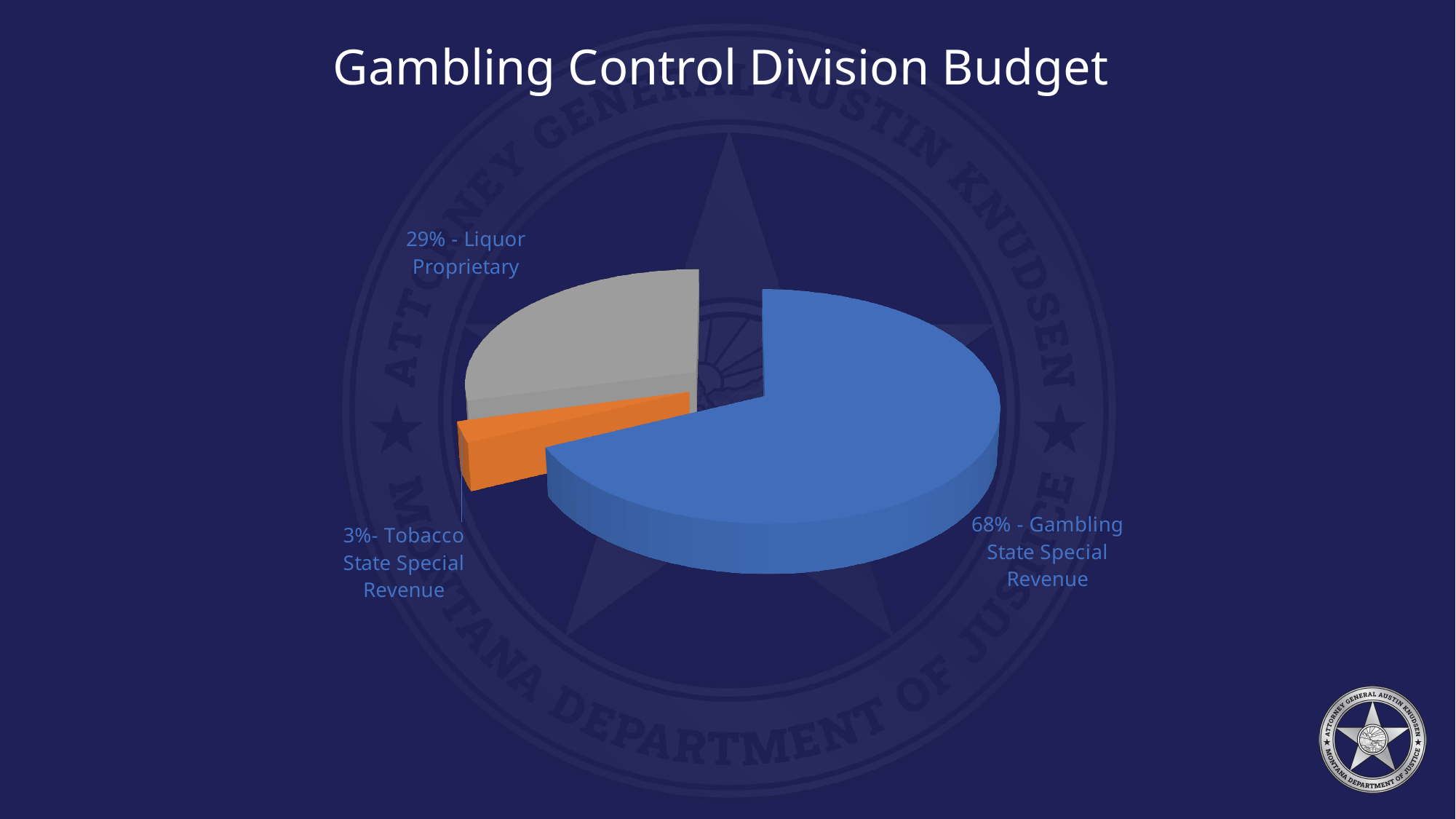
What is the title of the chart? Gambling Control Division Budget What share of the budget comes from Liquor Proprietary? 29% Which funding source makes up the smallest share of the budget? Tobacco State Special Revenue What is the difference in percentage points between the Liquor Proprietary share and the Tobacco State Special Revenue share? 26 Which funding source makes up the largest share of the budget? Gambling State Special Revenue What kind of chart is shown on the slide? Pie chart What share of the budget comes from Gambling State Special Revenue? 68% Which is larger, the Liquor Proprietary share or the Tobacco State Special Revenue share? Liquor Proprietary How many slices does the pie chart have? 3 What is the difference in percentage points between the Gambling State Special Revenue share and the Liquor Proprietary share? 39 What share of the budget comes from Tobacco State Special Revenue? 3% What colour is the Tobacco State Special Revenue slice? Orange